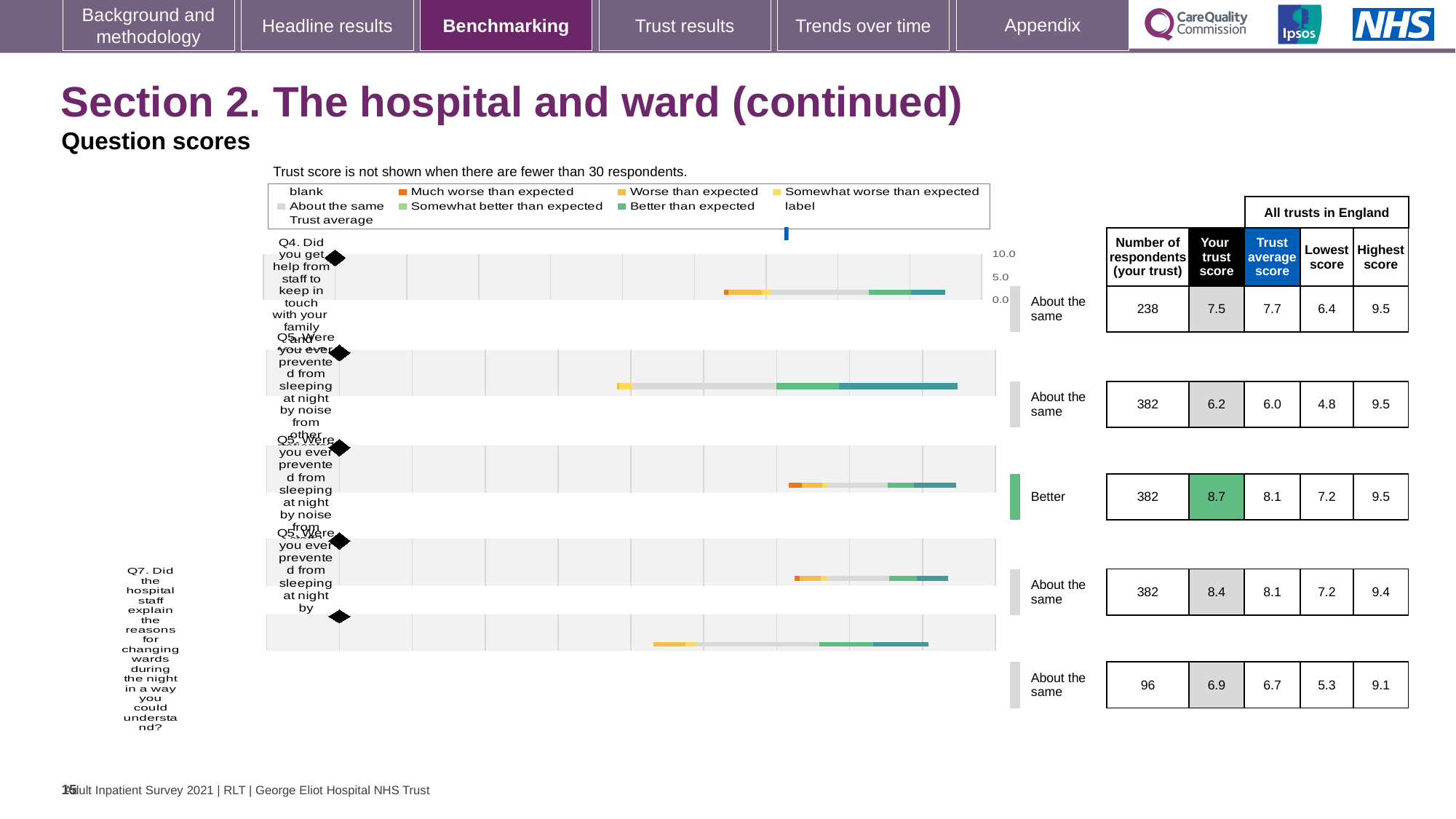
Is the trust score for Q4 larger or smaller than the trust score for Q7? larger What is the trust score for Q7 (hospital staff explaining reasons for changing wards during the night)? 6.9 How many respondents answered Q7 (hospital staff explaining reasons for changing wards during the night)? 96 What kind of chart is used to show the question scores on this slide? bar chart Which row has the highest trust score? the third row (8.7) Which row has the lowest trust score? the second row (6.2) How many question rows (bars) are plotted in the chart? 5 Which row is rated 'Better' rather than 'About the same'? the third row What is the difference between the trust score and the trust average score for the third row (8.7 vs 8.1)? 0.6 What is the highest score across all trusts in England for Q7? 9.1 What is the trust average score for Q4 (help from staff to keep in touch with family and friends)? 7.7 What is the trust score for Q4 (help from staff to keep in touch with family and friends)? 7.5